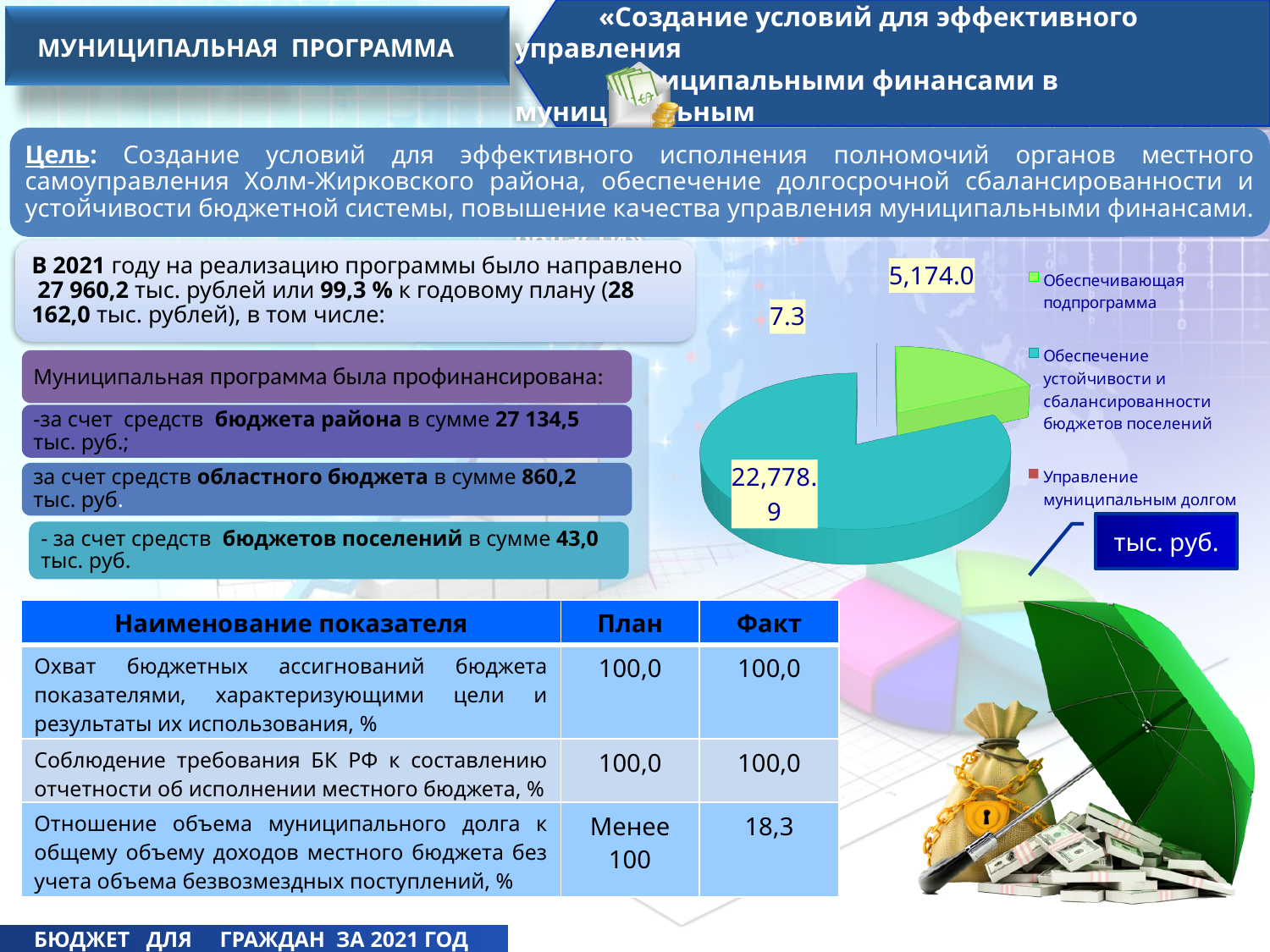
Which is larger in the pie chart: "Обеспечивающая подпрограмма" or "Управление муниципальным долгом"? Обеспечивающая подпрограмма What is the difference between the values for "Обеспечение устойчивости и сбалансированности бюджетов поселений" and "Обеспечивающая подпрограмма" in the pie chart? 17,604.9 How many entries does the pie chart legend list? 3 Which category has the largest slice in the pie chart? Обеспечение устойчивости и сбалансированности бюджетов поселений What is the value for "Обеспечение устойчивости и сбалансированности бюджетов поселений" in the pie chart? 22,778.9 What unit is indicated for the values in the pie chart? тыс. руб. How many slices does the pie chart have? 3 What colour is the slice for "Обеспечивающая подпрограмма" in the pie chart? green Which category has the smallest slice in the pie chart? Управление муниципальным долгом What is the value for "Обеспечивающая подпрограмма" in the pie chart? 5,174.0 What is the value for "Управление муниципальным долгом" in the pie chart? 7.3 What kind of chart is shown on the slide? pie chart